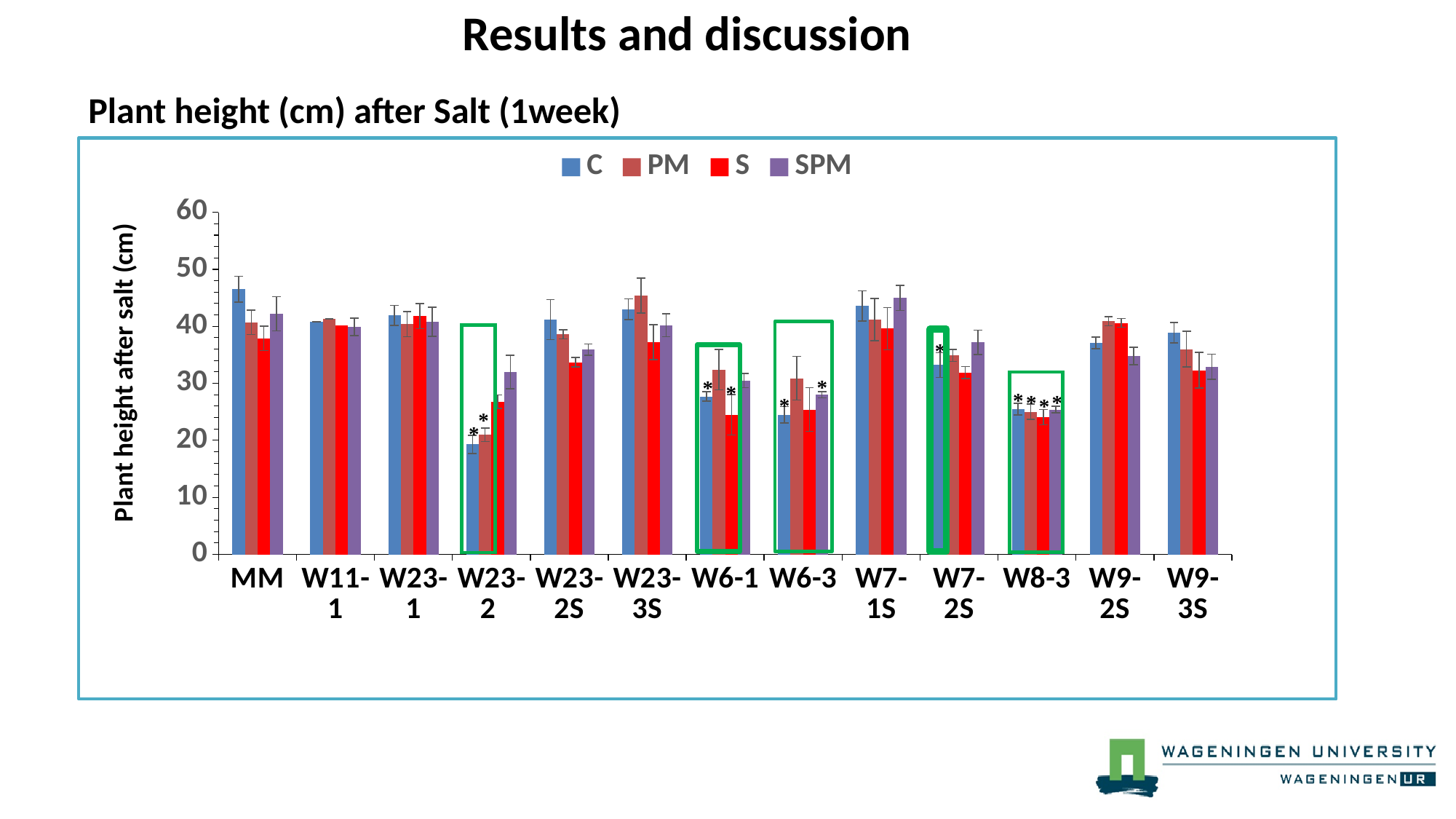
Is the value for SPM in the W7-1S category greater or less than 40? greater Is the value for S in the W6-1 category greater or less than 30? less How many categories are shown on the x axis? 13 How many series does the legend list? 4 Which category has the highest C bar? MM Which category has the lowest C bar? W23-2 What is the y-axis title of the chart? Plant height after salt (cm) Is the value for C in the MM category greater or less than 40? greater Which is larger in the MM category, the C bar or the S bar? C Which is larger in the W23-2 category, the C bar or the SPM bar? SPM What kind of chart is shown on the slide? bar chart